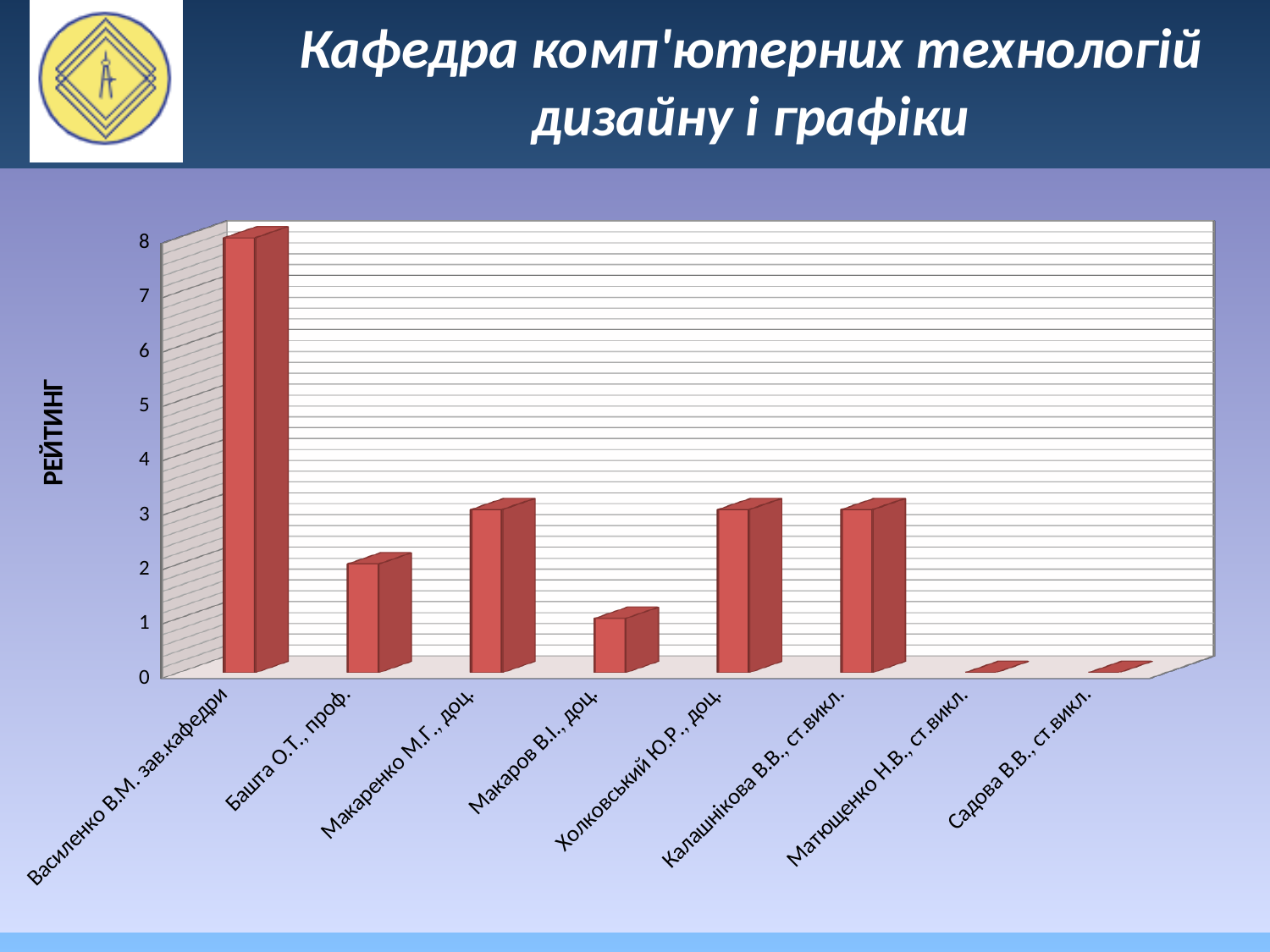
What is the rating value for Башта О.Т., проф.? 2 Is the rating for Василенко В.М. зав.кафедри greater or less than 5? greater What is the rating value for Макаров В.І., доц.? 1 Which category has the highest rating in the chart? Василенко В.М. зав.кафедри What is the rating value for Василенко В.М. зав.кафедри? 8 What is the rating value for Холковський Ю.Р., доц.? 3 How many categories (staff members) are shown on the x axis of the chart? 8 What is the difference between the rating of Василенко В.М. зав.кафедри and the rating of Макаренко М.Г., доц.? 5 Which has a larger rating: Башта О.Т., проф. or Калашнікова В.В., ст.викл.? Калашнікова В.В., ст.викл. What is the label of the vertical axis of the chart? РЕЙТИНГ What is the rating value for Матющенко Н.В., ст.викл.? 0 What kind of chart is shown on the slide? bar chart